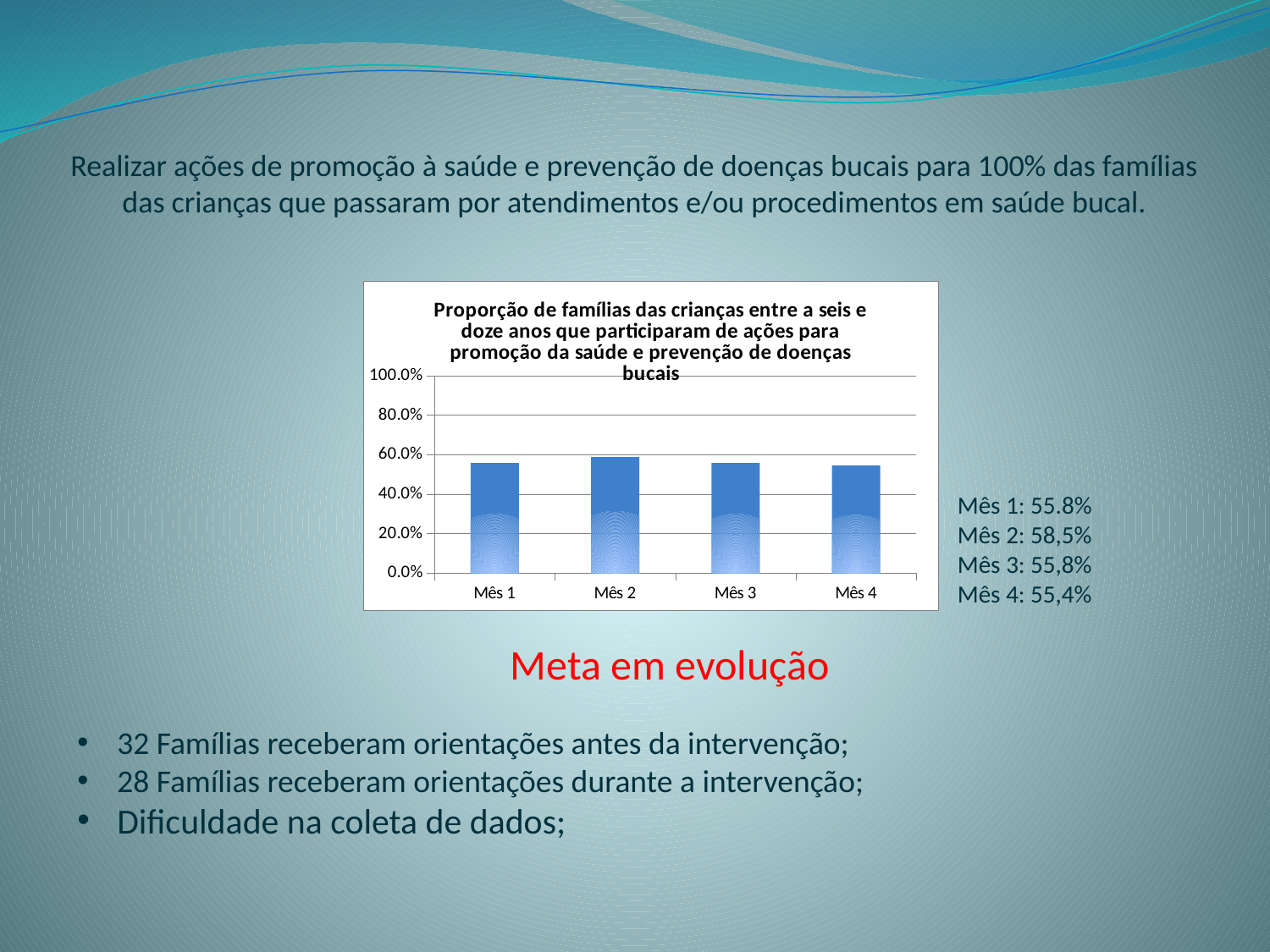
What is the value for Mês 3? 55,8% Which month has the highest value? Mês 2 How many months are shown on the x axis of the chart? 4 What is the value for Mês 2? 58,5% What is the value for Mês 1? 55.8% Which is larger, the value for Mês 2 or the value for Mês 3? Mês 2 What is the highest value shown on the chart's y axis? 100.0% What kind of chart is shown on the slide? bar chart What is the difference between the values for Mês 2 and Mês 1? 2.7% Is the value for Mês 2 greater or less than 40%? greater Is the value for Mês 1 greater or less than 60%? less What is the value for Mês 4? 55,4%